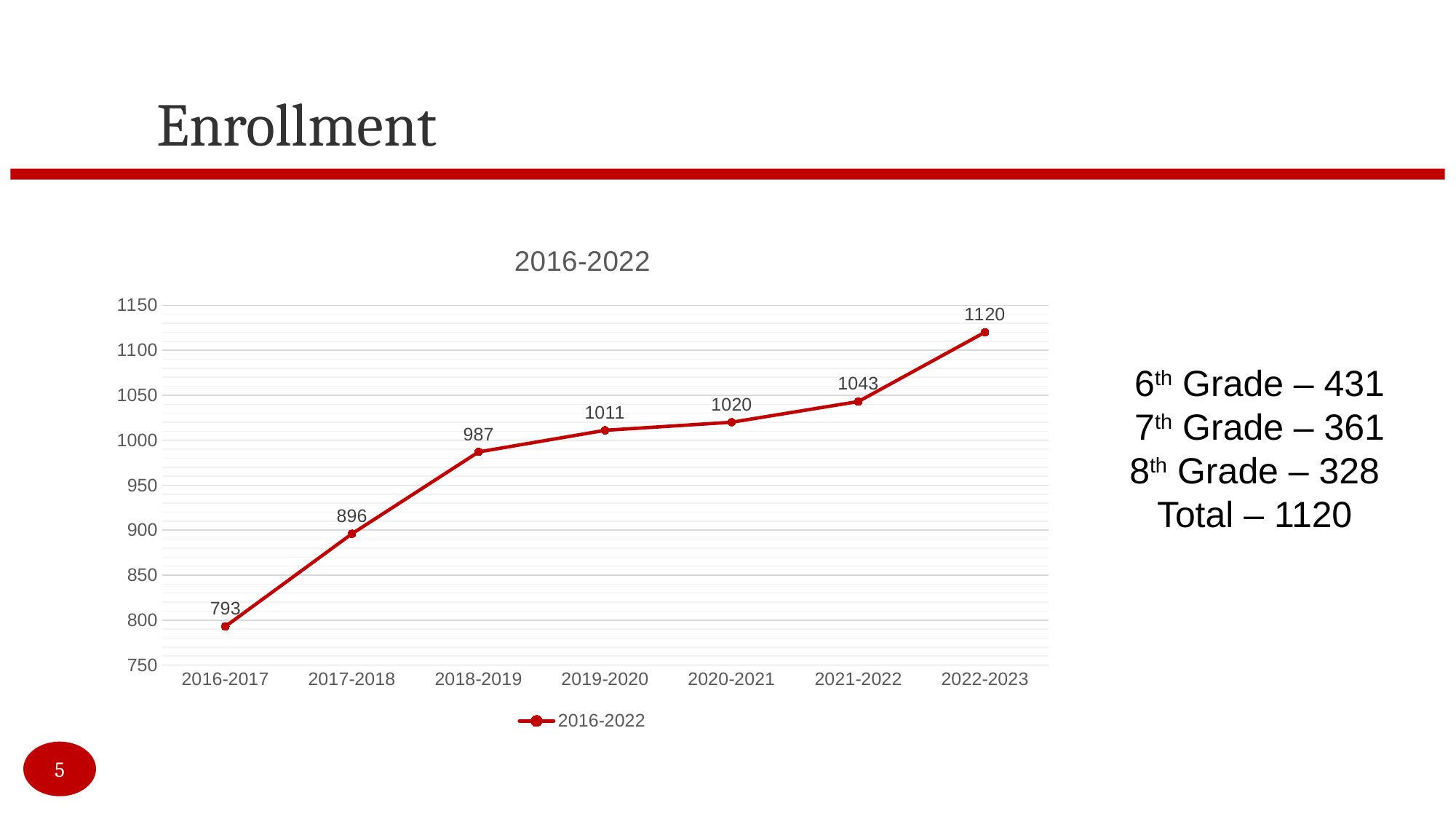
Which year has the highest enrollment? 2022-2023 What is the difference in enrollment between 2017-2018 and 2016-2017? 103 What is the enrollment value for 2018-2019? 987 What kind of chart is shown on the slide? line chart Does enrollment rise or fall from 2016-2017 to 2022-2023? rise What is the enrollment value for 2016-2017? 793 What is the enrollment value for 2020-2021? 1020 How many school years are plotted on the chart? 7 Is the enrollment for 2021-2022 greater or less than 1000? greater Which year has the lowest enrollment? 2016-2017 Which is larger, the enrollment for 2019-2020 or for 2017-2018? 2019-2020 What is the difference in enrollment between 2022-2023 and 2021-2022? 77